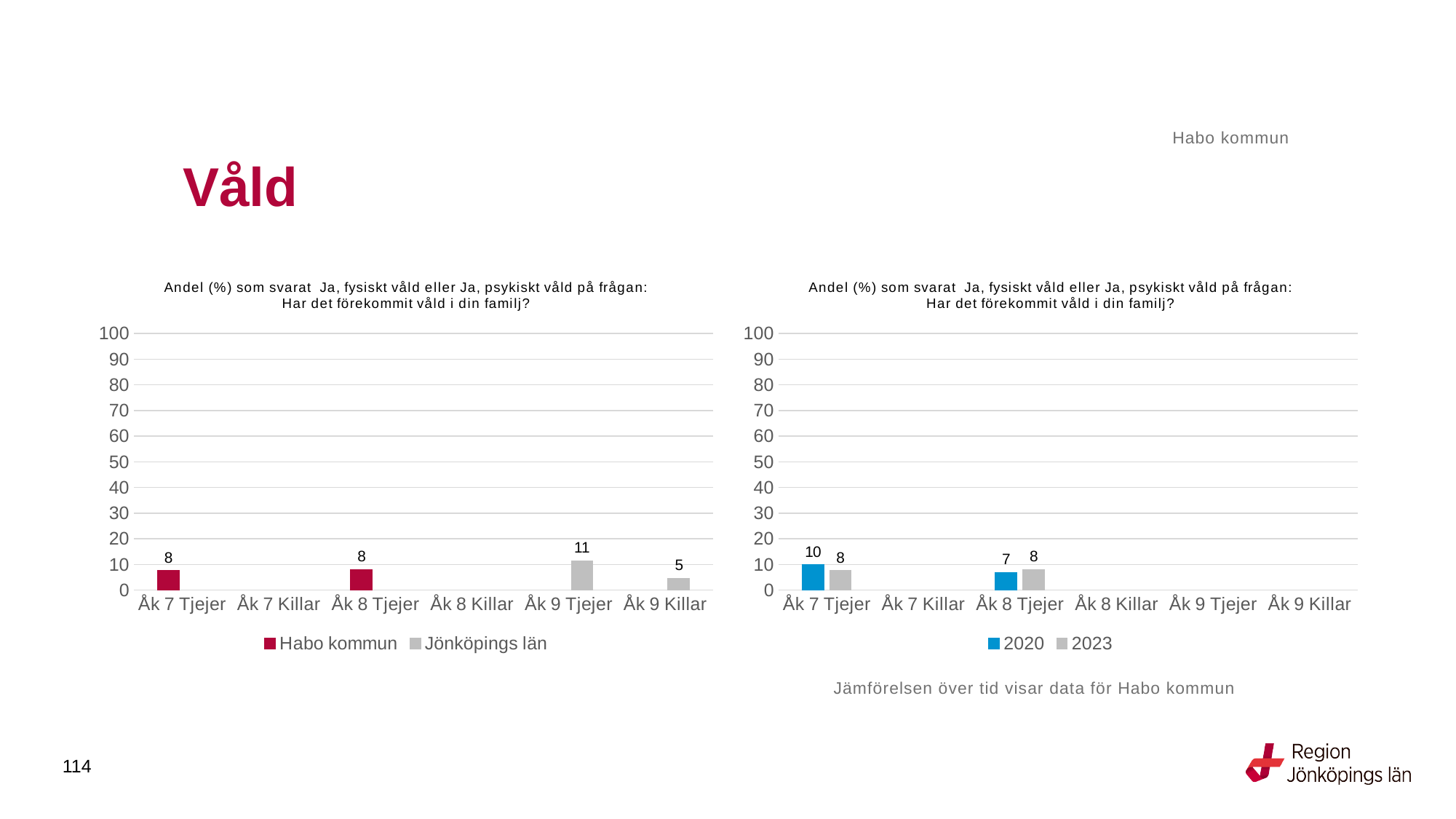
What kind of chart is the right chart? Bar chart In the left chart, what is the difference between the Jönköpings län values for Åk 9 Tjejer and Åk 9 Killar? 6 In the left chart, what is the value for Habo kommun for Åk 7 Tjejer? 8 In the left chart, what is the value for Jönköpings län for Åk 9 Killar? 5 In the right chart, what is the difference between the 2020 and 2023 values for Åk 8 Tjejer? 1 In the left chart, what is the value for Jönköpings län for Åk 9 Tjejer? 11 In the right chart, which is larger for Åk 7 Tjejer, the 2020 value or the 2023 value? 2020 In the left chart, how many series does the legend list? 2 In the right chart, what is the value for 2020 for Åk 7 Tjejer? 10 In the right chart, what are the two series listed in the legend? 2020 and 2023 In the right chart, what is the value for 2023 for Åk 8 Tjejer? 8 In the left chart, how many categories are shown on the x axis? 6